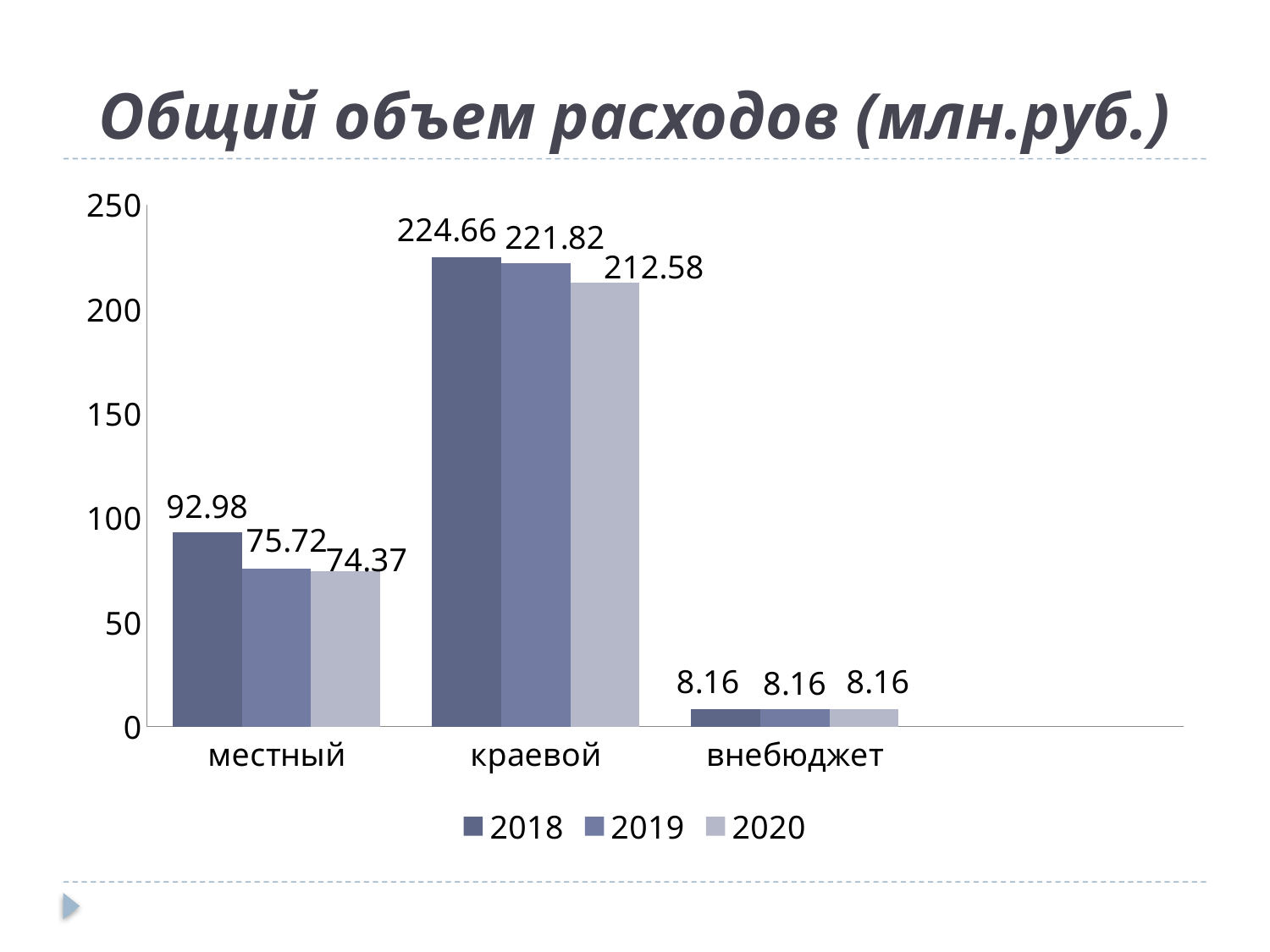
What is the title of the chart? Общий объем расходов (млн.руб.) What is the value for краевой in 2020? 212.58 What is the value for местный in 2018? 92.98 What kind of chart is shown on the slide? bar chart How many categories are shown on the x axis? 3 Which is larger: the 2019 value for местный or the 2020 value for местный? 2019 How many series does the legend list? 3 Which category has the lowest value in 2020? внебюджет What is the difference between the 2018 and 2019 values for краевой? 2.84 Which category has the highest value in 2019? краевой What is the difference between the 2018 and 2020 values for местный? 18.61 What is the value for внебюджет in 2019? 8.16